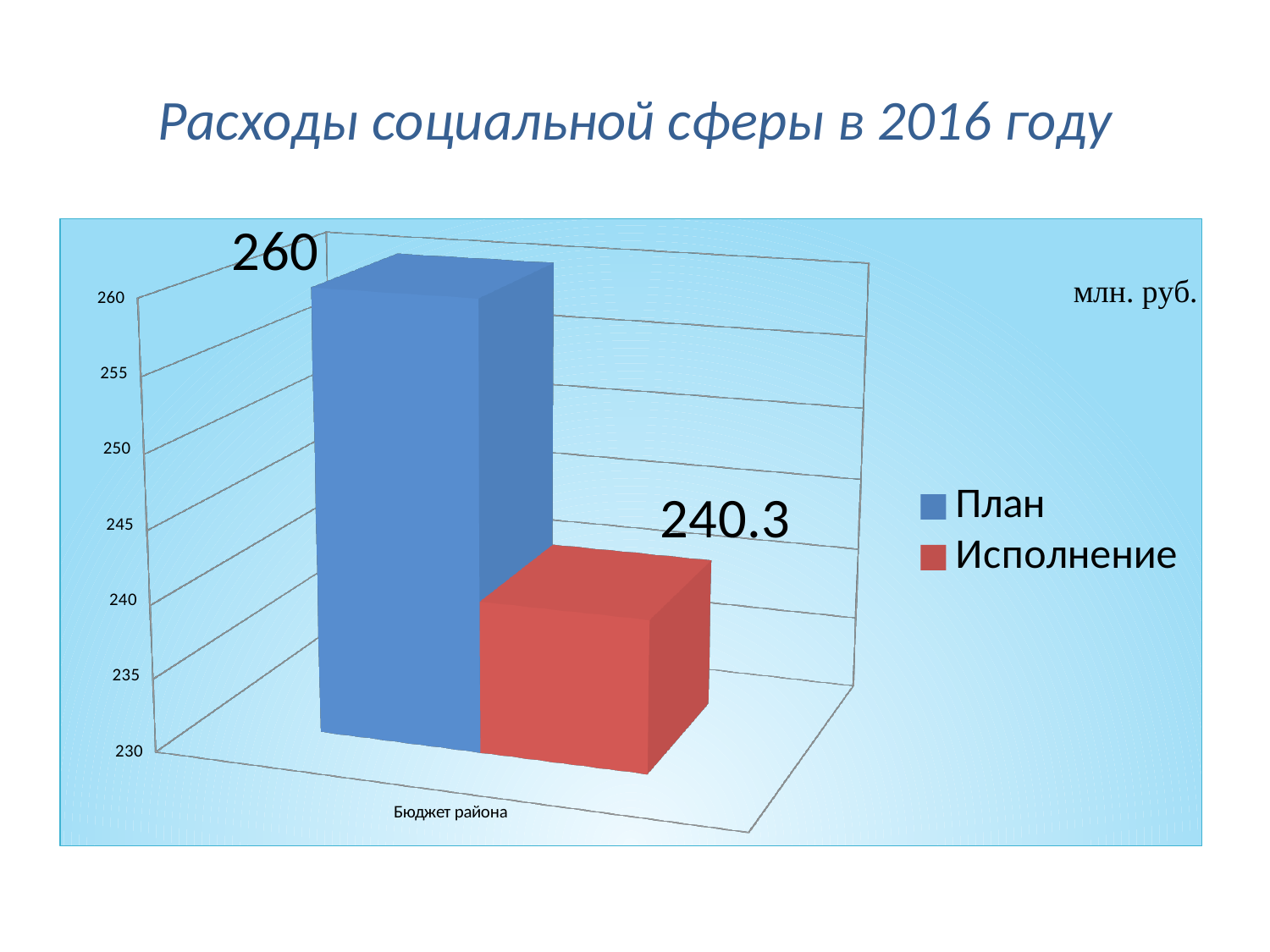
What unit is indicated on the chart? млн. руб. Is the value for Исполнение greater or less than 245? less What is the category label on the x axis? Бюджет района What is the value for Исполнение (Execution) in the chart? 240.3 What is the difference between the План value and the Исполнение value? 19.7 What is the title of the slide's chart? Расходы социальной сферы в 2016 году Which series has the lowest value in the chart? Исполнение What is the value for План (Plan) in the chart? 260 How many series does the legend list? 2 How many categories are shown on the x axis? 1 Which series has the higher value, План or Исполнение? План What kind of chart is shown on the slide? Bar chart